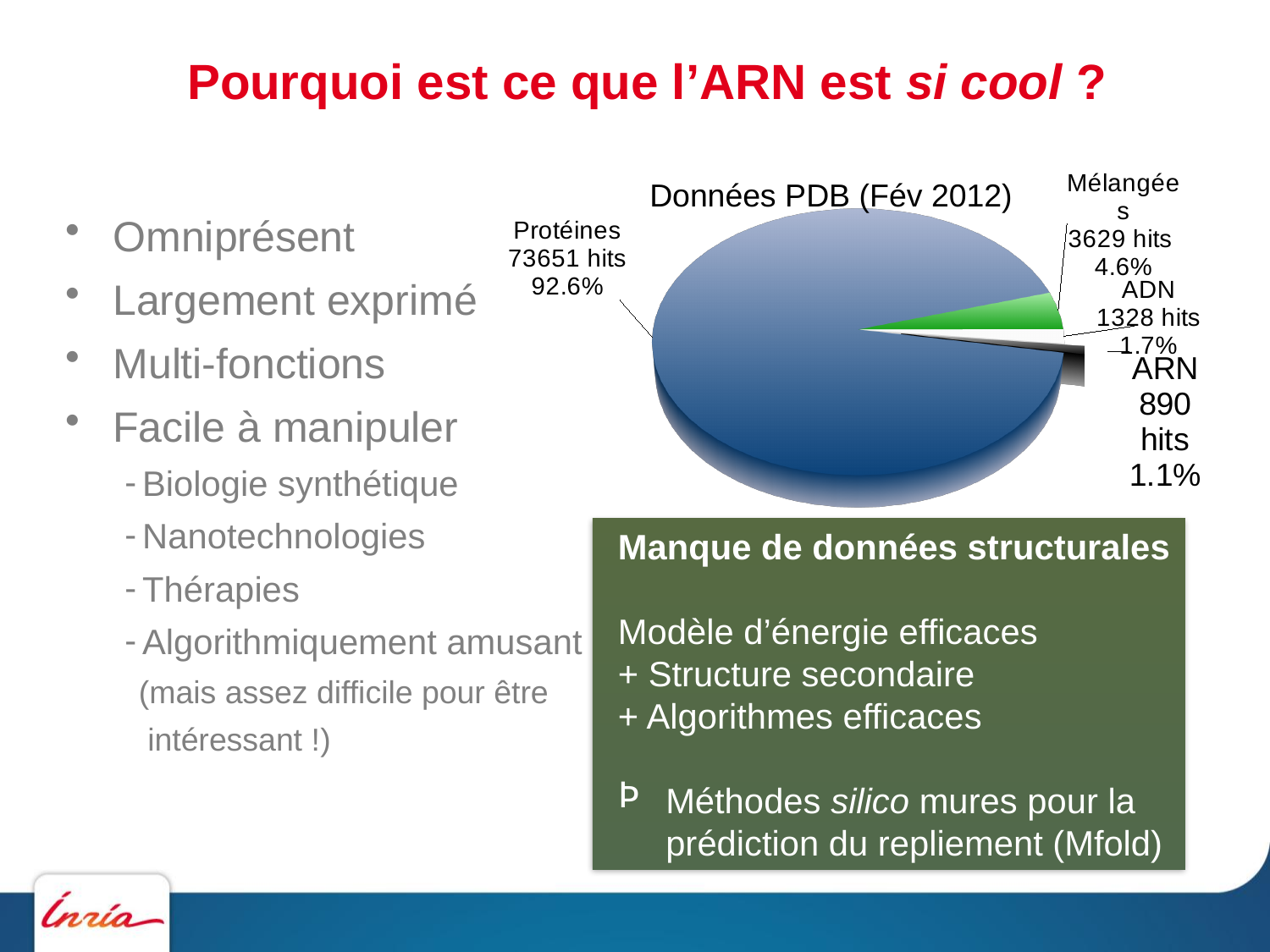
What is the title of the pie chart? Données PDB (Fév 2012) What share of the pie does the ARN slice represent? 1.1% How many slices does the pie chart have? 4 How many hits does the ARN slice represent? 890 hits Which category has the largest slice of the pie? Protéines What share of the pie does the Protéines slice represent? 92.6% What is the difference in hits between ADN and ARN? 438 hits Which category has the smallest slice of the pie? ARN How many hits does the Protéines slice represent? 73651 hits What kind of chart is shown on the slide? pie chart What share of the pie does the Mélangées slice represent? 4.6% How many hits does the ADN slice represent? 1328 hits